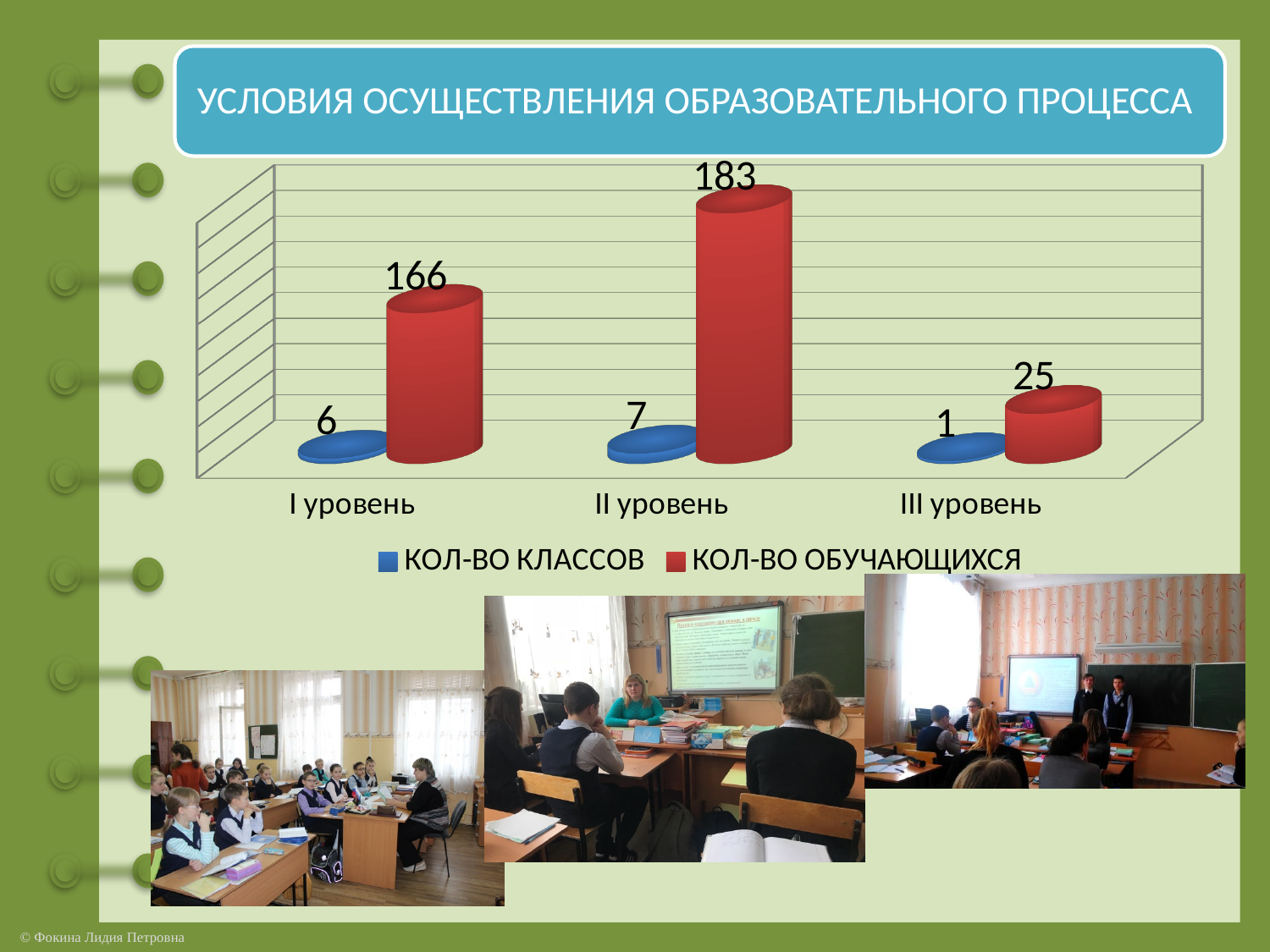
What is the value for КОЛ-ВО ОБУЧАЮЩИХСЯ at II уровень? 183 Which category has the highest value for КОЛ-ВО ОБУЧАЮЩИХСЯ? II уровень Which category has the lowest value for КОЛ-ВО КЛАССОВ? III уровень How many series does the legend list? 2 What is the difference between КОЛ-ВО ОБУЧАЮЩИХСЯ at II уровень and at I уровень? 17 Which colour represents КОЛ-ВО ОБУЧАЮЩИХСЯ in the legend? Red Which is larger: КОЛ-ВО КЛАССОВ at I уровень or at II уровень? II уровень What is the value for КОЛ-ВО ОБУЧАЮЩИХСЯ at III уровень? 25 How many categories are shown on the x axis? 3 What is the value for КОЛ-ВО КЛАССОВ at III уровень? 1 What is the value for КОЛ-ВО КЛАССОВ at I уровень? 6 What kind of chart is shown on the slide? Bar chart